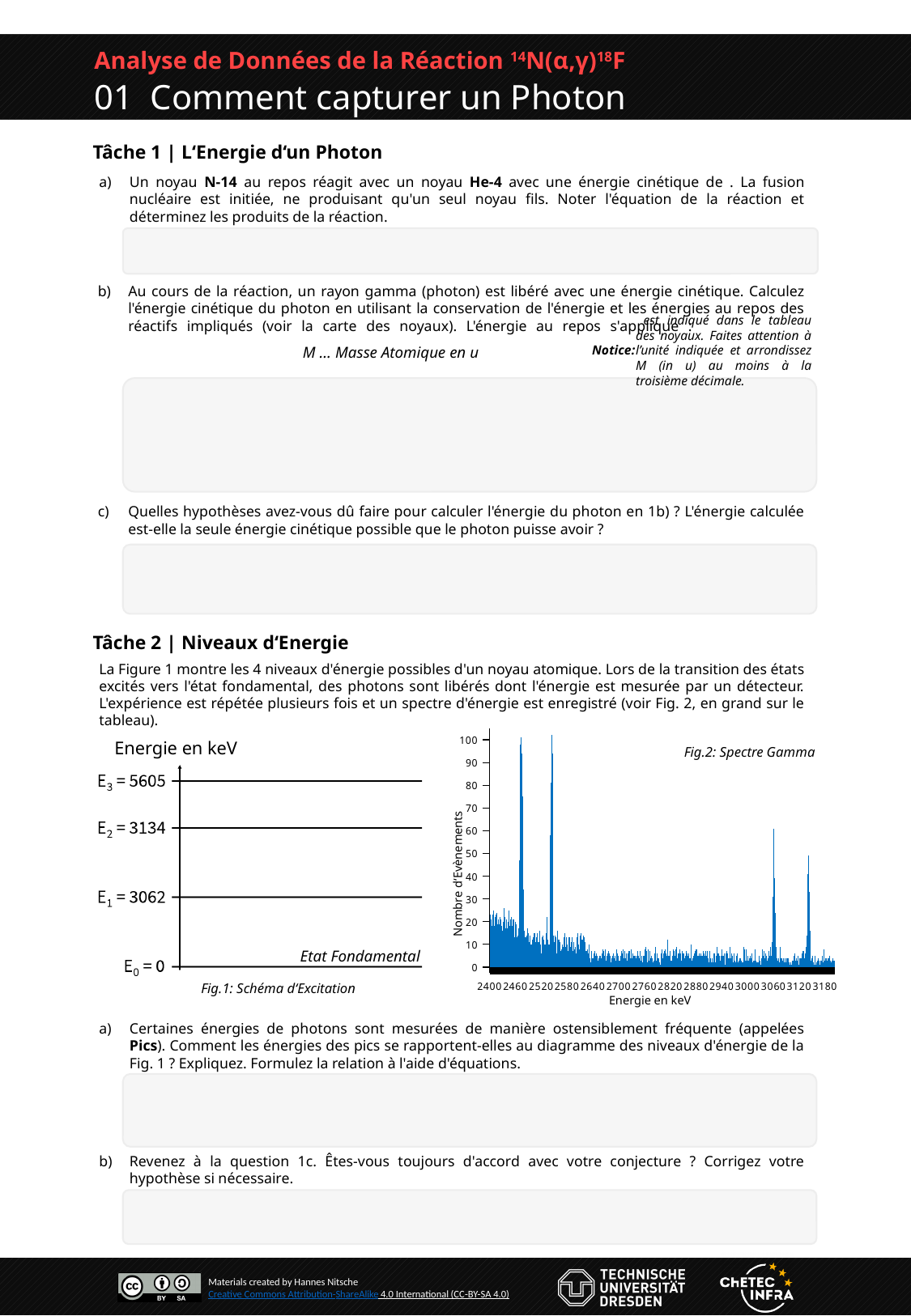
In Fig.1: Schéma d'Excitation, what is the energy of level E2 in keV? 3134 In Fig.1: Schéma d'Excitation, what is the difference in keV between E2 and E1? 72 In Fig.2: Spectre Gamma, is the background level around 2880 keV greater or less than 20 events? less What is the title of the chart on the right side of the slide? Fig.2: Spectre Gamma In Fig.2: Spectre Gamma, what is the label of the x axis? Energie en keV In Fig.2: Spectre Gamma, which peak is taller: the one near 2460 keV or the one near 3060 keV? the one near 2460 keV In Fig.2: Spectre Gamma, which peak is taller: the one near 3060 keV or the one near 3120 keV? the one near 3060 keV In Fig.2: Spectre Gamma, how many prominent peaks stand out above the background? 4 What kind of chart is Fig.2: Spectre Gamma? bar chart In Fig.2: Spectre Gamma, is the height of the peak near 3120 keV greater or less than 40 events? greater In Fig.2: Spectre Gamma, is the height of the peak near 3060 keV greater or less than 50 events? greater